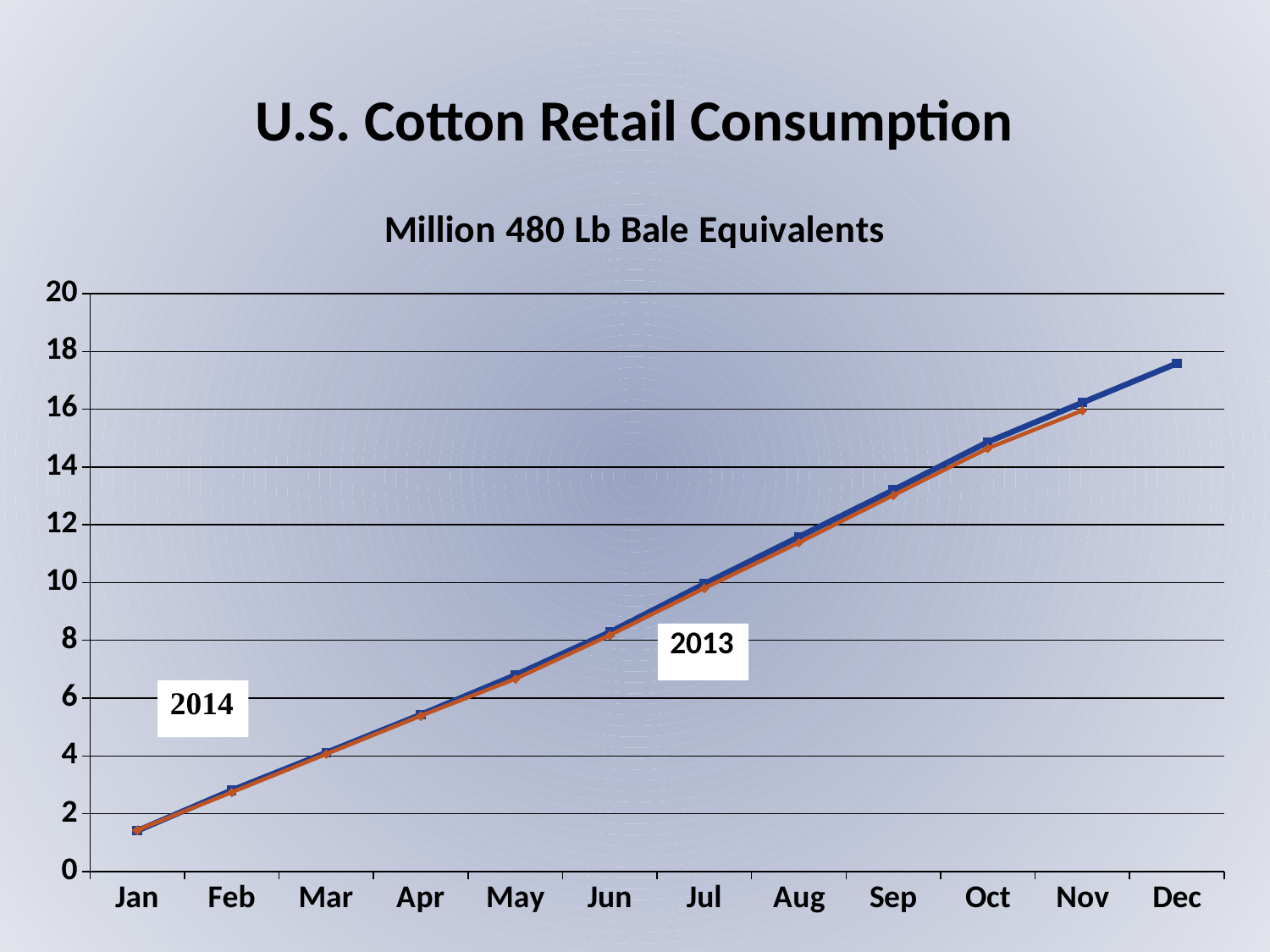
Are the Apr values of both lines greater or less than 6? less What unit is stated in the chart's subtitle? Million 480 Lb Bale Equivalents Are the Jan values of both lines greater or less than 2? less Are the Aug values of both lines greater or less than 10? greater Which month has the highest plotted value on the chart? Dec Do the plotted values rise or fall from Jan to Dec? rise How many lines (series) are plotted on the chart? 2 What kind of chart is shown on the slide? line chart How many months are shown along the x axis? 12 What is the title of the chart? U.S. Cotton Retail Consumption